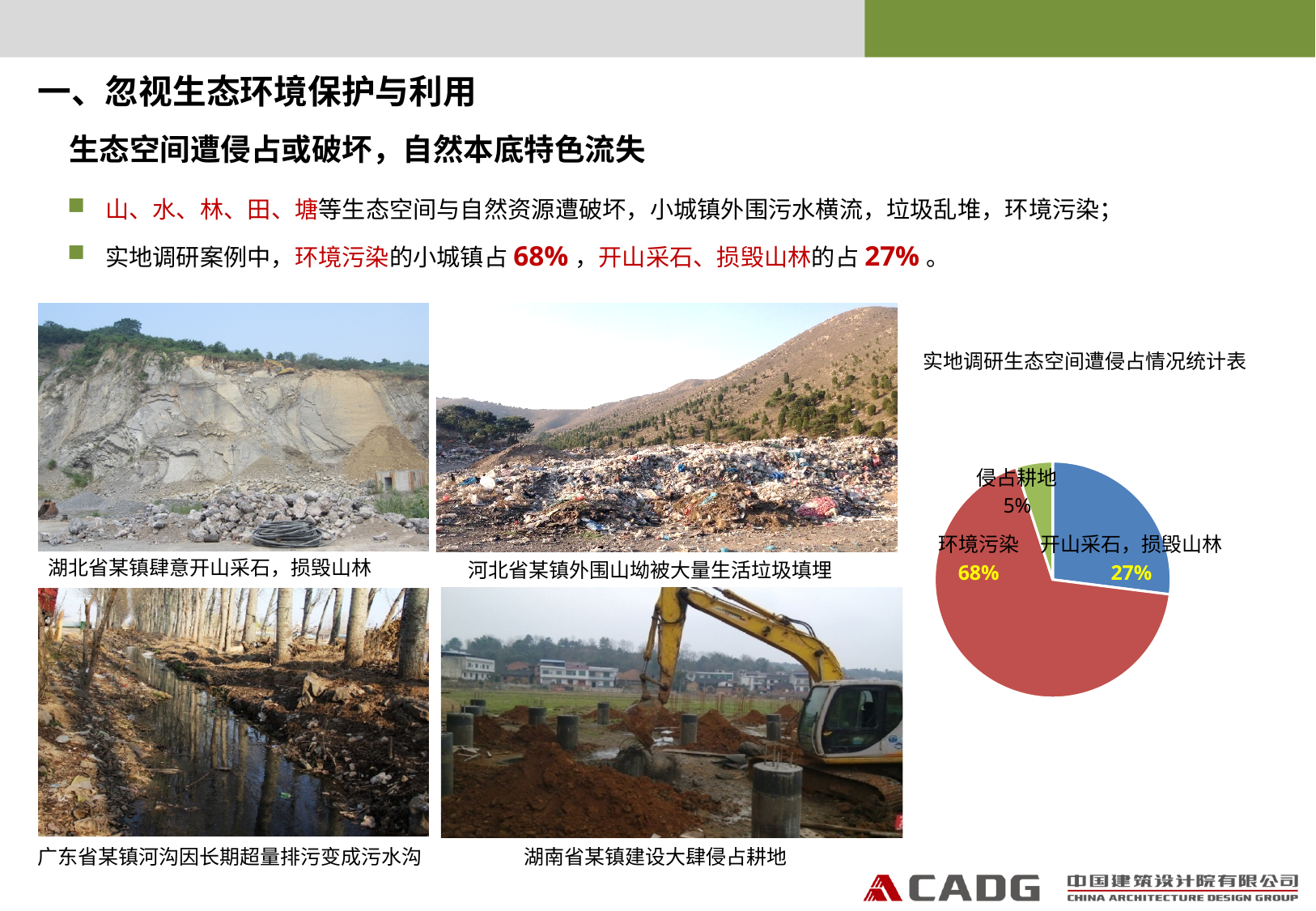
What share of the pie does 侵占耕地 account for? 5% What is the difference in percentage points between 环境污染 and 开山采石，损毁山林? 41% What type of chart is shown on the slide? Pie chart What share of the pie does 环境污染 account for? 68% How many slices does the pie chart have? 3 Which category has the smallest slice in the pie chart? 侵占耕地 Which is larger, the share for 开山采石，损毁山林 or the share for 侵占耕地? 开山采石，损毁山林 What is the title of the pie chart? 实地调研生态空间遭侵占情况统计表 What colour is the 环境污染 slice in the pie chart? Red What share of the pie does 开山采石，损毁山林 account for? 27% Which category has the largest slice in the pie chart? 环境污染 What is the difference in percentage points between 开山采石，损毁山林 and 侵占耕地? 22%